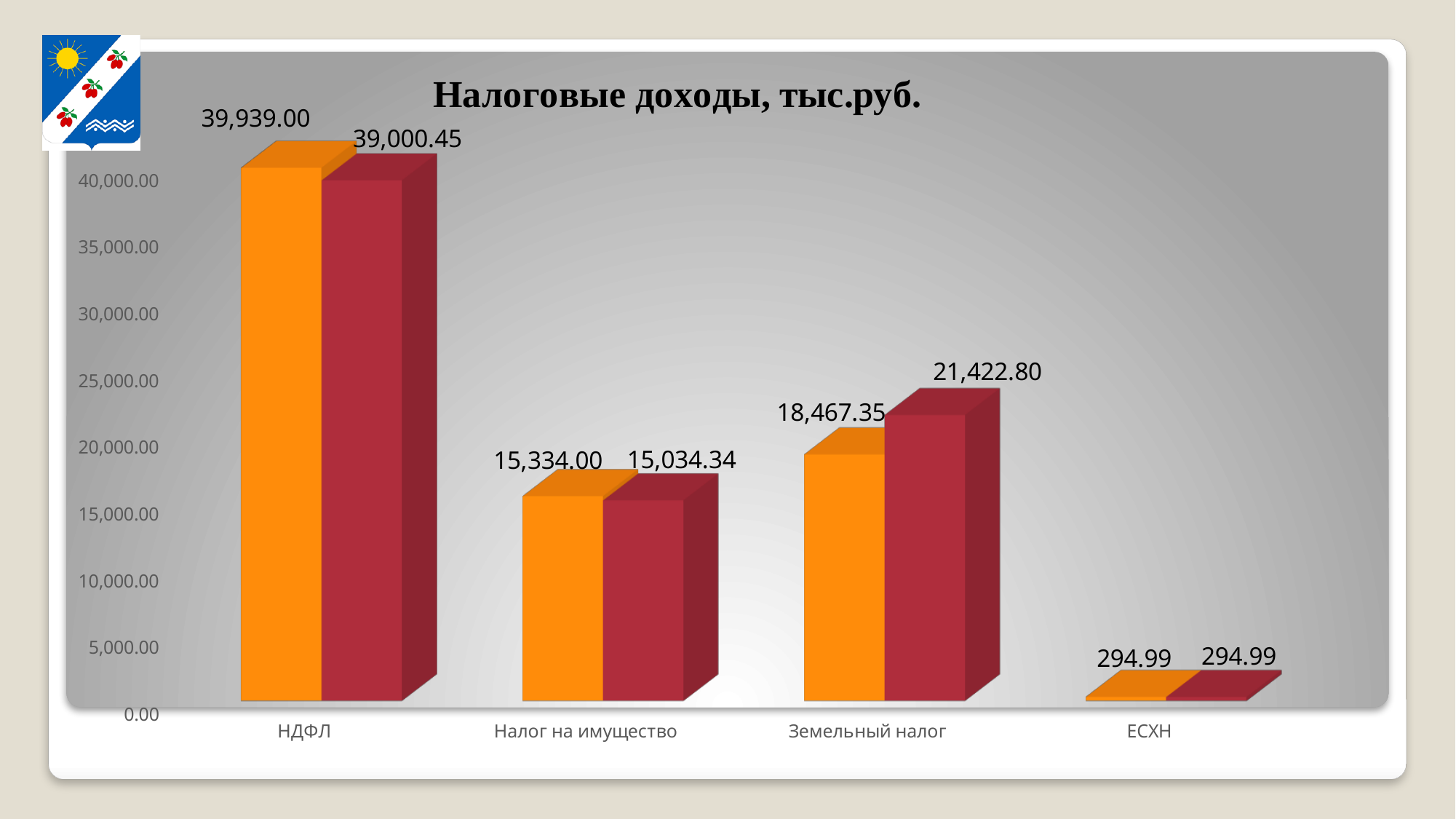
Which category has the lowest red bar? ЕСХН What is the value of the red bar for Земельный налог? 21,422.80 For Земельный налог, which bar is larger, the orange or the red one? red What is the value of the orange bar for ЕСХН? 294.99 What is the difference between the orange and red bars for НДФЛ? 938.55 How many categories are shown on the x axis of the chart? 4 What is the difference between the red and orange bars for Земельный налог? 2,955.45 Which category has the highest orange bar? НДФЛ What type of chart is shown on the slide? bar chart What is the value of the orange bar for НДФЛ? 39,939.00 What is the title of the chart? Налоговые доходы, тыс.руб. What is the value of the red bar for Налог на имущество? 15,034.34